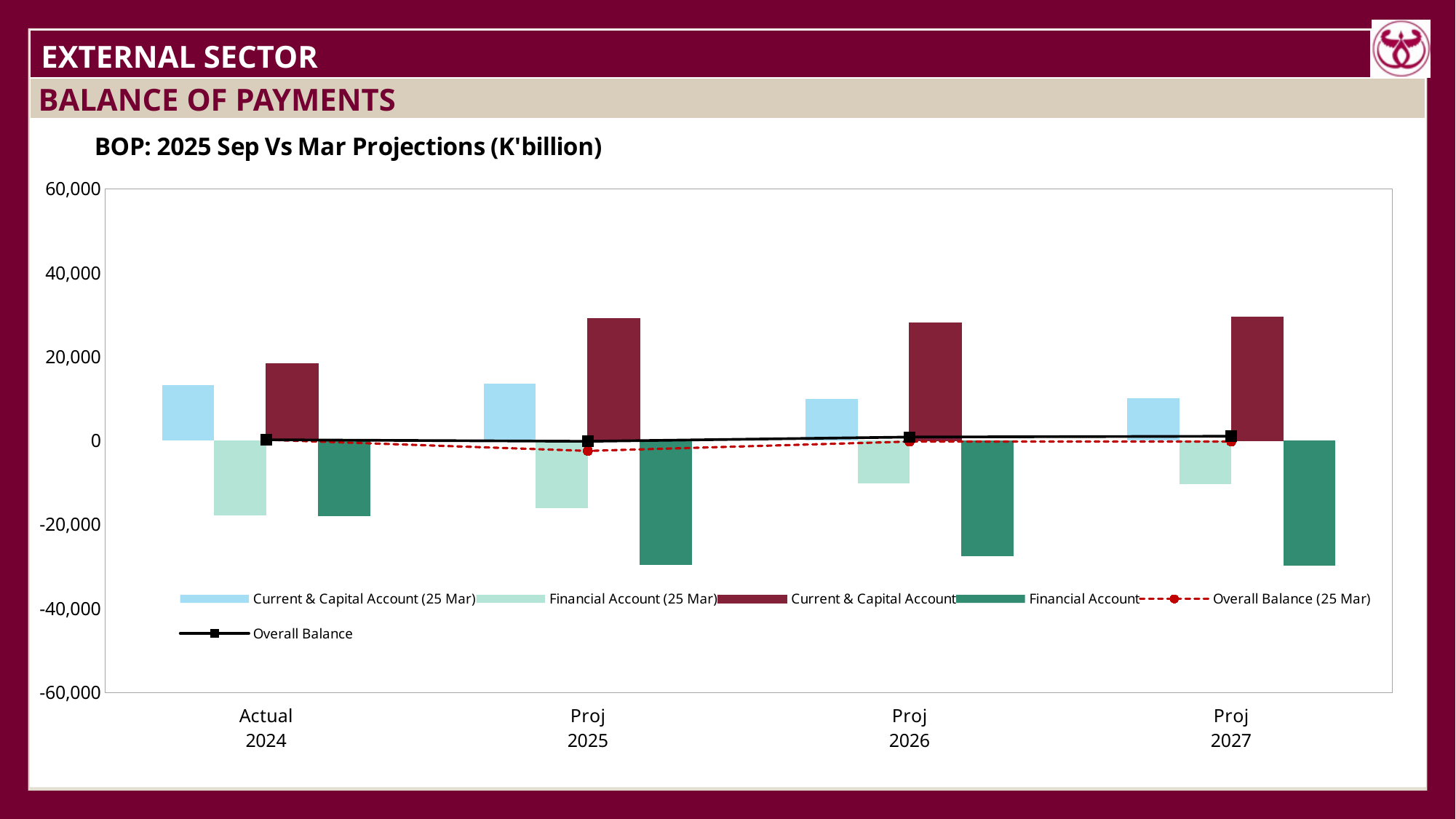
What kind of chart is shown on the slide? bar chart (with line series) How many series does the legend list? 6 Is the value for Financial Account (25 Mar) in Actual 2024 greater or less than -20,000? greater Is the value for Financial Account in Proj 2025 greater or less than -20,000? less What is the title of the chart? BOP: 2025 Sep Vs Mar Projections (K'billion) In Proj 2025, which is larger: Current & Capital Account or Current & Capital Account (25 Mar)? Current & Capital Account How many categories are shown on the x axis? 4 Is the value for Current & Capital Account in Actual 2024 greater or less than 20,000? less For Financial Account (25 Mar), which is lower: Actual 2024 or Proj 2026? Actual 2024 In which category is the Current & Capital Account value lowest? Actual 2024